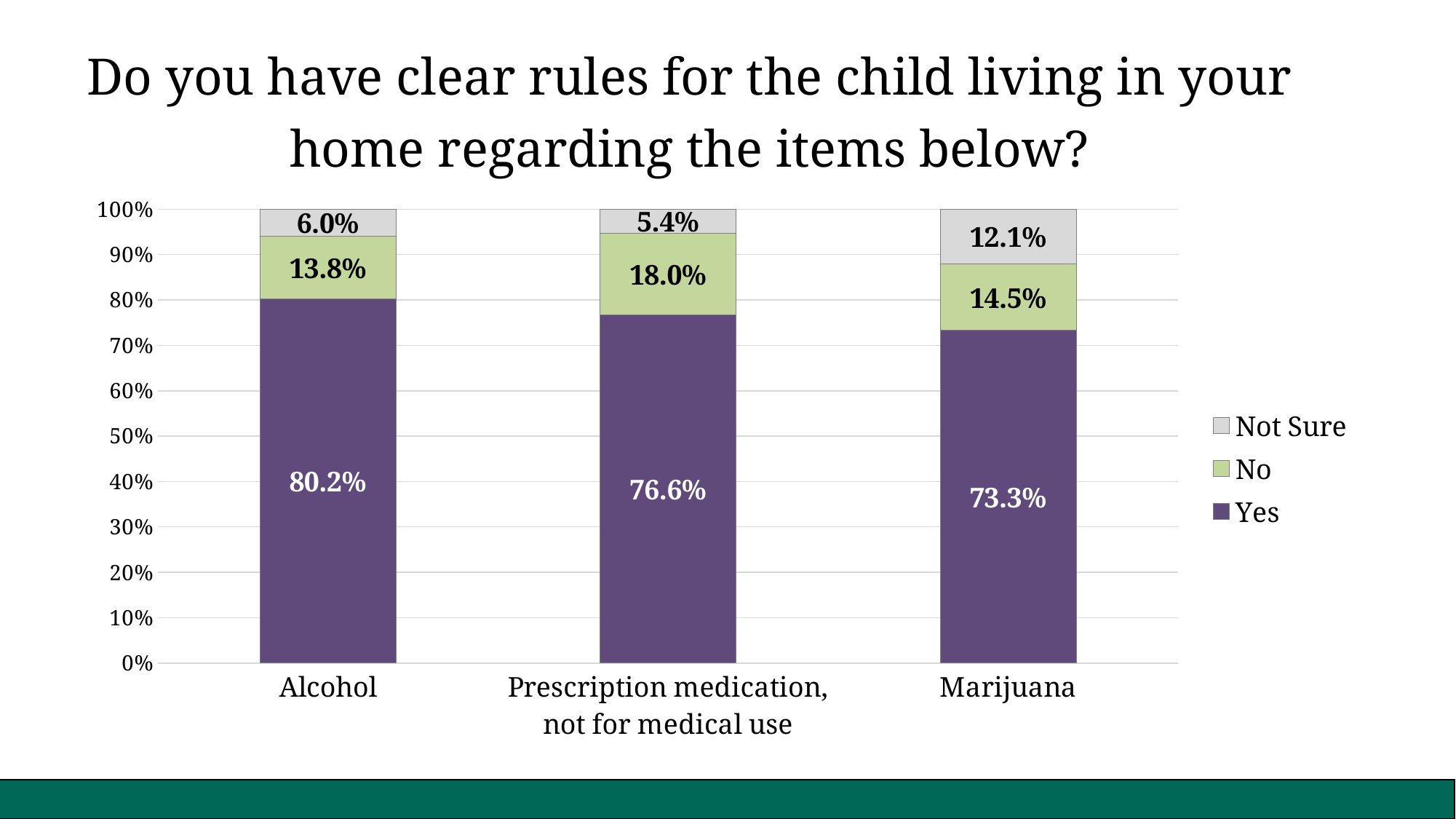
What percentage of respondents answered No for Prescription medication, not for medical use? 18.0% Which colour represents the Yes series in the chart? Purple How many categories are shown on the x axis? 3 What kind of chart is shown on the slide? Stacked bar chart Which category has the highest Yes percentage? Alcohol Which is larger: the No percentage for Alcohol or the No percentage for Marijuana? Marijuana Which category has the lowest Not Sure percentage? Prescription medication, not for medical use What percentage of respondents answered Yes for Alcohol? 80.2% What percentage of respondents answered Not Sure for Marijuana? 12.1% How many series does the legend list? 3 What is the difference between the Yes percentages for Alcohol and Marijuana? 6.9% Do the Yes percentages rise or fall from Alcohol to Marijuana along the x axis? Fall